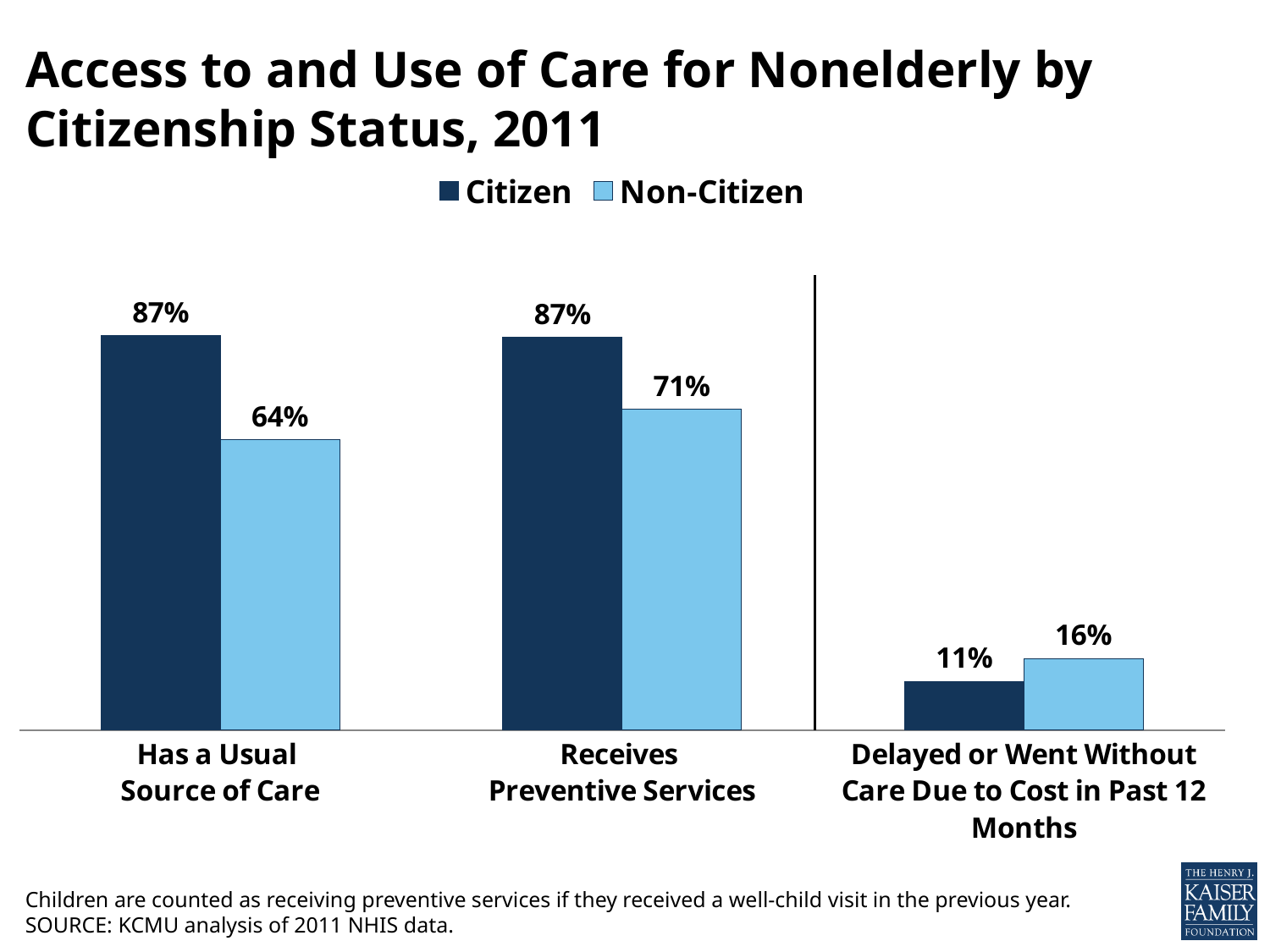
What percentage of citizens delayed or went without care due to cost in the past 12 months? 11% How many series does the legend list? 2 What percentage of non-citizens receives preventive services? 71% What is the difference between the citizen and non-citizen values for receiving preventive services? 16 percentage points What is the difference between the citizen and non-citizen values for having a usual source of care? 23 percentage points What percentage of non-citizens has a usual source of care? 64% What percentage of non-citizens delayed or went without care due to cost in the past 12 months? 16% For which category is the non-citizen value lowest? Delayed or Went Without Care Due to Cost in Past 12 Months How many categories are shown on the x axis? 3 What percentage of citizens has a usual source of care? 87% Which group has the higher value for delayed or went without care due to cost in the past 12 months, citizens or non-citizens? Non-Citizen What kind of chart is shown on the slide? Bar chart